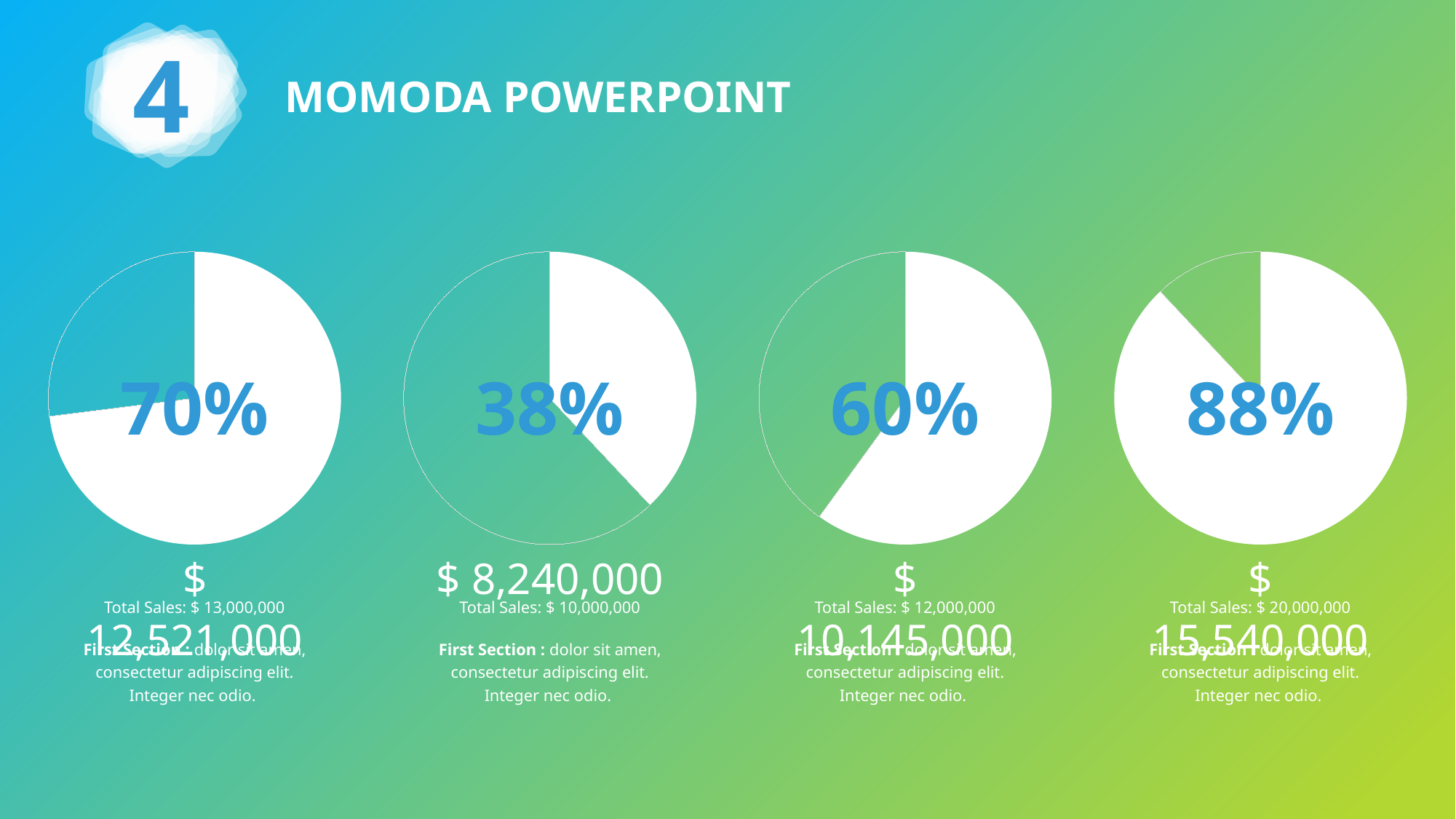
What percentage is shown in the fourth (rightmost) pie chart? 88% What is the Total Sales figure printed under the rightmost pie chart? $ 20,000,000 Which of the four pie charts shows the lowest percentage? The second pie chart from the left (38%) Which of the four pie charts shows the highest percentage? The rightmost pie chart (88%) What percentage is shown in the first (leftmost) pie chart? 70% What percentage is shown in the second pie chart from the left? 38% How many pie charts are on the slide? 4 What kind of chart is used on this slide? Pie chart What is the difference between the percentage in the rightmost pie chart and the percentage in the leftmost pie chart? 18% What percentage is shown in the third pie chart from the left? 60% What is the title of the slide containing the pie charts? MOMODA POWERPOINT Is the percentage in the leftmost pie chart larger or smaller than the percentage in the third pie chart? larger